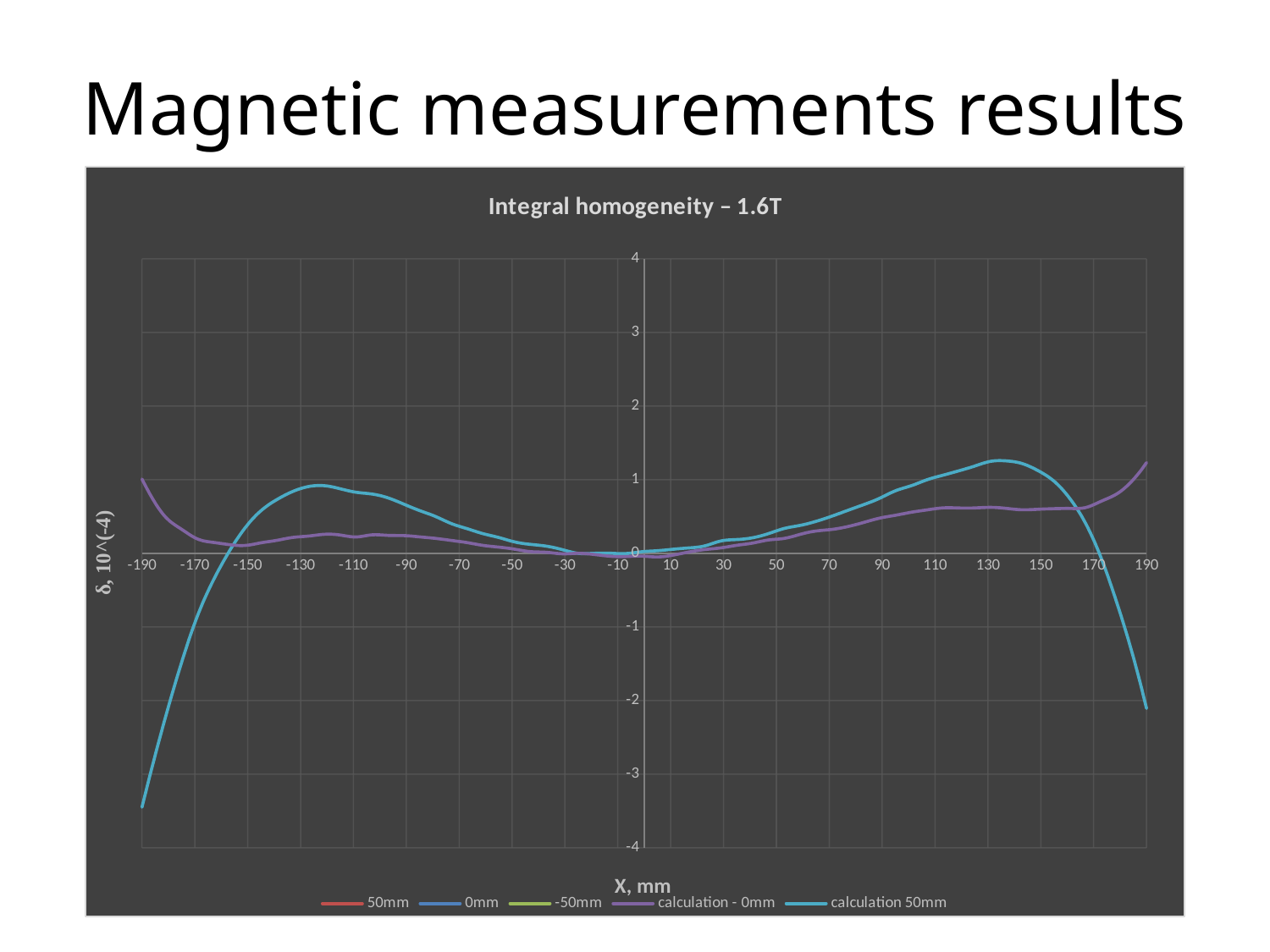
Is the value of the 'calculation - 0mm' series at X = 110 greater or less than 1? less Is the value of the 'calculation 50mm' series at X = 190 greater or less than -1? less At X = 130, which series has the higher value: 'calculation - 0mm' or 'calculation 50mm'? calculation 50mm At which X value does the 'calculation 50mm' series reach its lowest value? -190 What kind of chart is shown on the slide? line chart Is the value of the 'calculation 50mm' series at X = 130 greater or less than 1? greater How many series does the chart legend list? 5 Does the 'calculation 50mm' series rise or fall between X = 150 and X = 190? fall What is the label of the x axis? X, mm At X = -190, which series has the higher value: 'calculation - 0mm' or 'calculation 50mm'? calculation - 0mm What is the title of the chart? Integral homogeneity – 1.6T